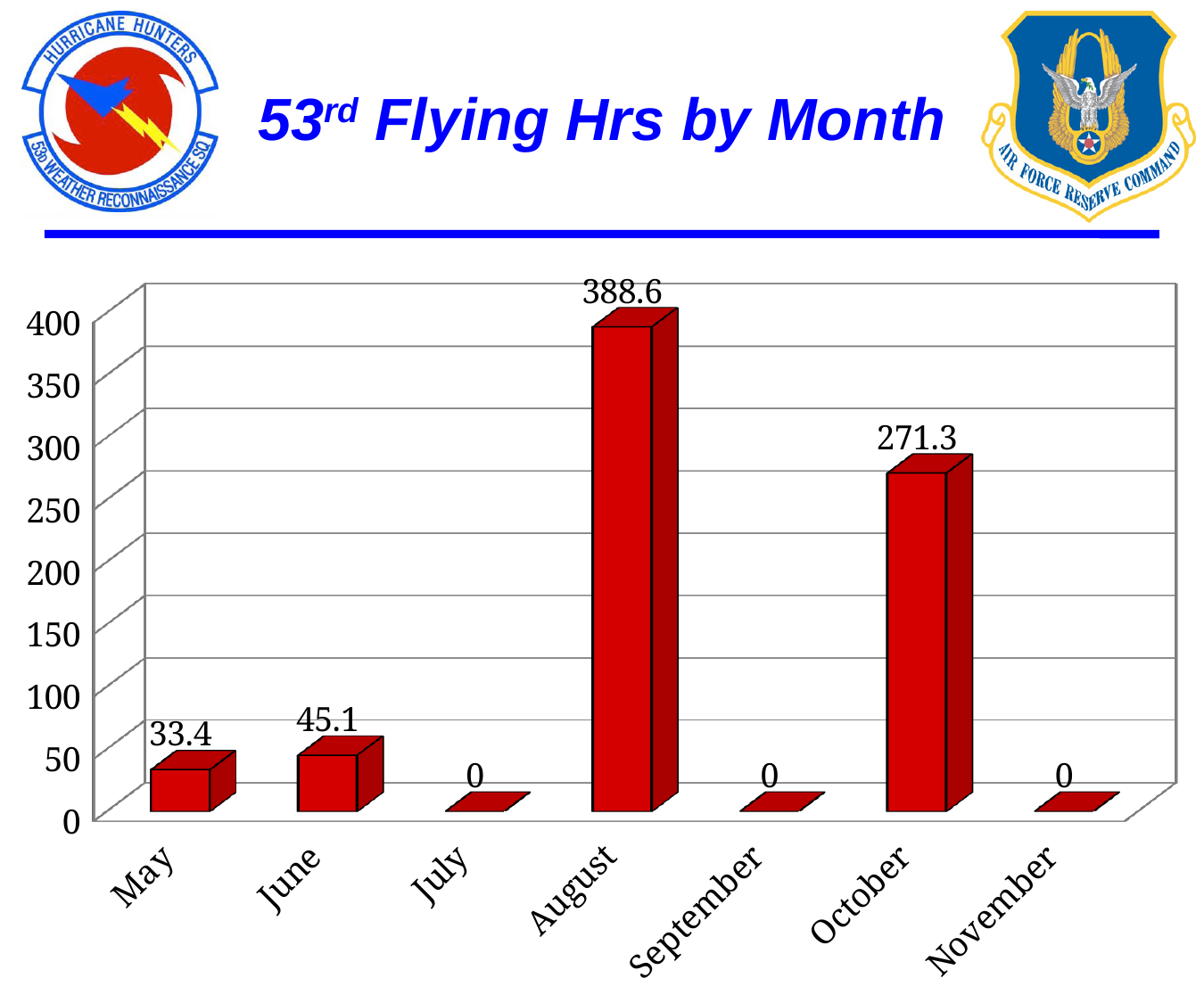
What is the value for August? 388.6 What is the value for October? 271.3 What is the value for September? 0 Which month has the highest value? August What is the value for June? 45.1 Which is larger, the value for June or the value for May? June How many months are shown on the x axis? 7 What is the difference between the values for June and May? 11.7 What is the value for May? 33.4 What kind of chart is shown on the slide? Bar chart What is the difference between the values for August and October? 117.3 What is the title of the chart? 53rd Flying Hrs by Month